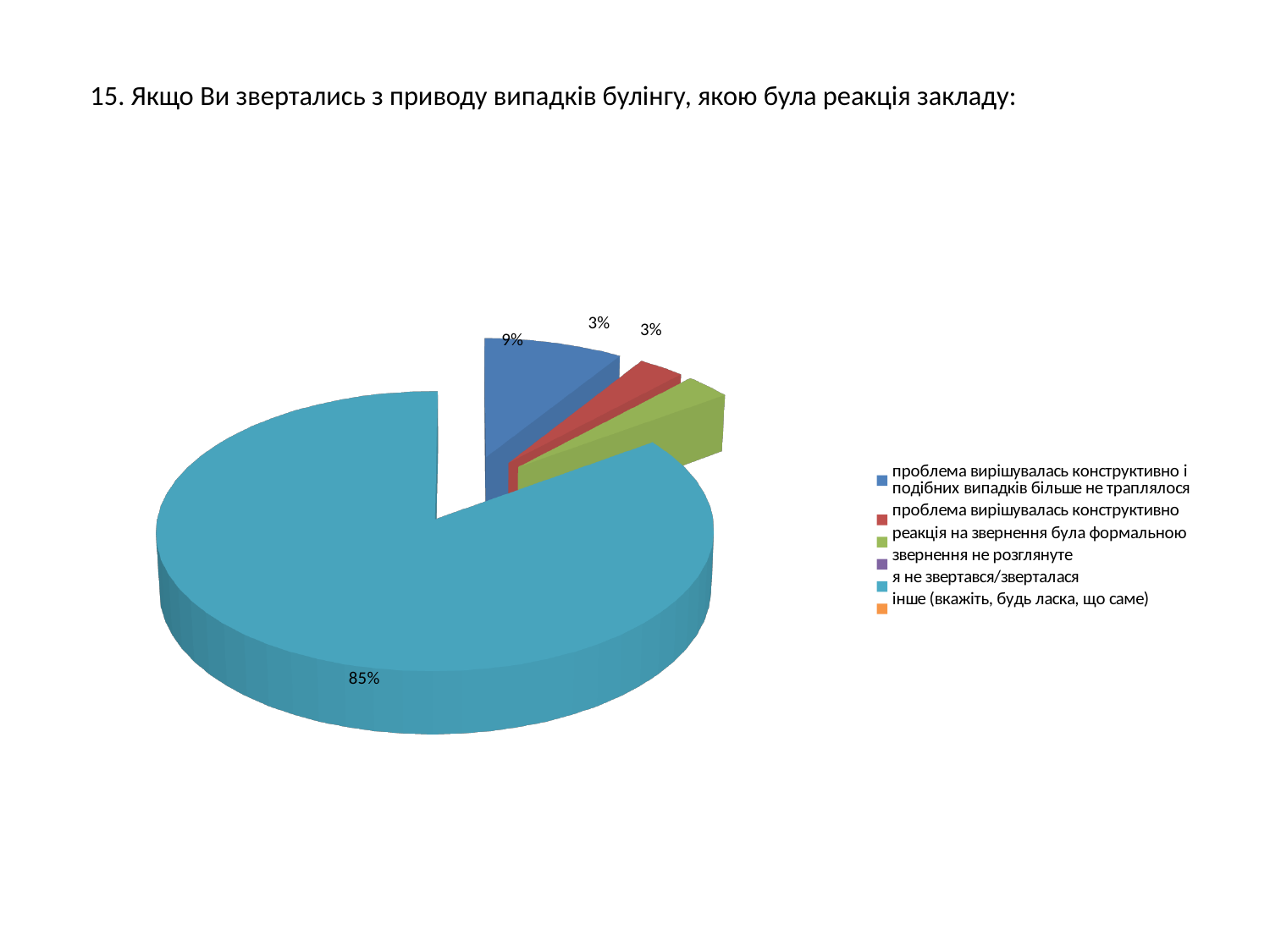
What percentage is shown for "проблема вирішувалась конструктивно і подібних випадків більше не траплялося"? 9% How many slices of the pie have a percentage label printed? 4 Which is larger: the slice for "проблема вирішувалась конструктивно і подібних випадків більше не траплялося" or the slice for "реакція на звернення була формальною"? проблема вирішувалась конструктивно і подібних випадків більше не траплялося What kind of chart is shown on the slide? pie chart Which category has the largest slice of the pie? я не звертався/зверталася What share of the pie is labelled for "я не звертався/зверталася"? 85% How many entries does the legend list? 6 What is the difference in percentage points between "я не звертався/зверталася" and "проблема вирішувалась конструктивно і подібних випадків більше не траплялося"? 76 percentage points What percentage is shown for "реакція на звернення була формальною"? 3% What is the sum of the four percentage labels shown on the pie? 100% What percentage is shown for "проблема вирішувалась конструктивно"? 3% What is the title of the chart on the slide? 15. Якщо Ви звертались з приводу випадків булінгу, якою була реакція закладу: